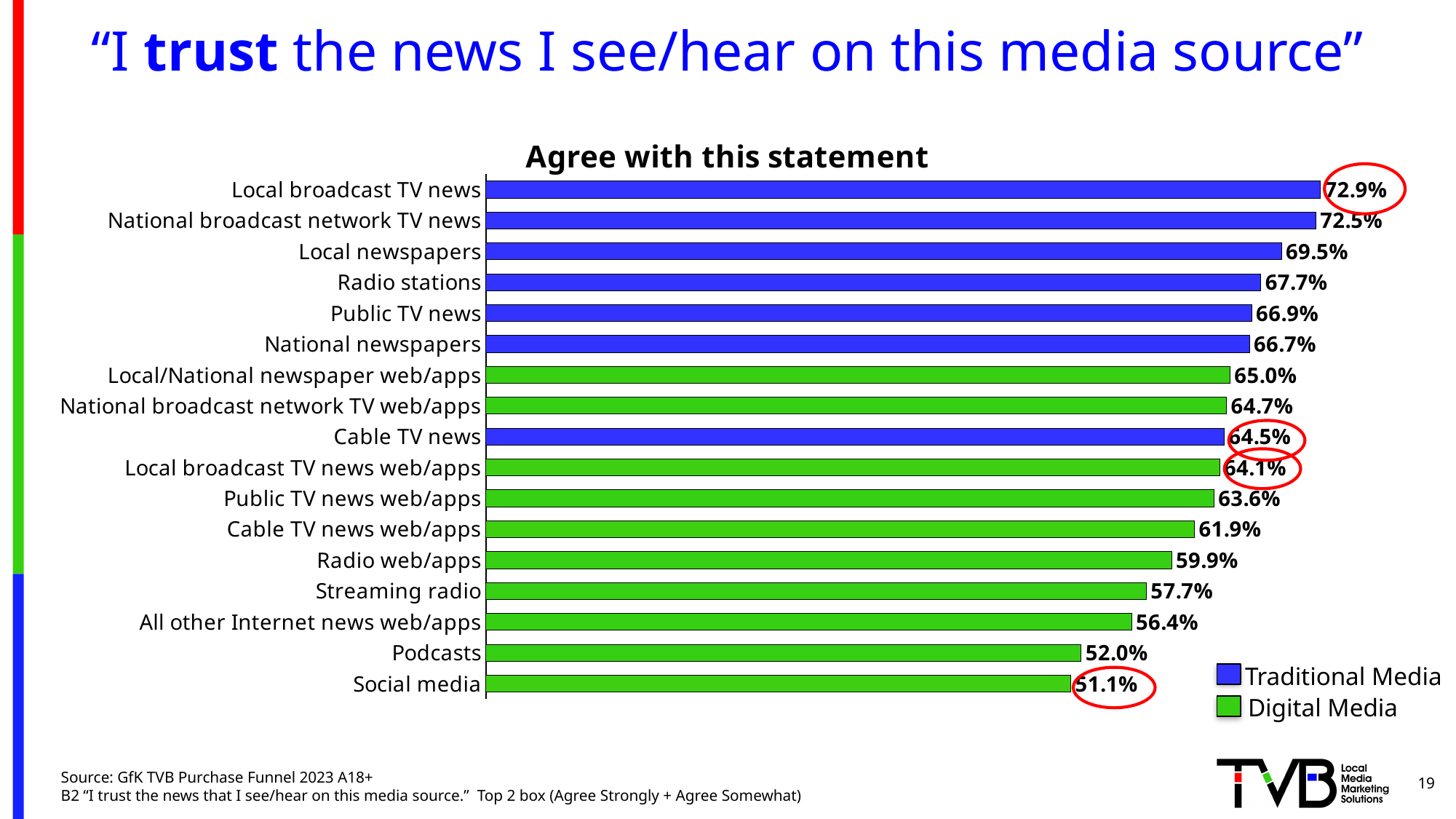
What is the value shown for Podcasts? 52.0% What percentage agree that they trust the news on Local broadcast TV news? 72.9% What is the value shown for Cable TV news? 64.5% Which media source has the highest percentage agreeing with the statement? Local broadcast TV news How many series does the legend list? 2 What kind of chart is shown on the slide? Bar chart How many media sources are listed in the chart? 17 What is the difference between the values for Local broadcast TV news and Social media? 21.8% Which has a higher value, Radio stations or Streaming radio? Radio stations Which media source has the lowest percentage agreeing with the statement? Social media What is the value shown for Social media? 51.1% Which legend entry is shown in green? Digital Media